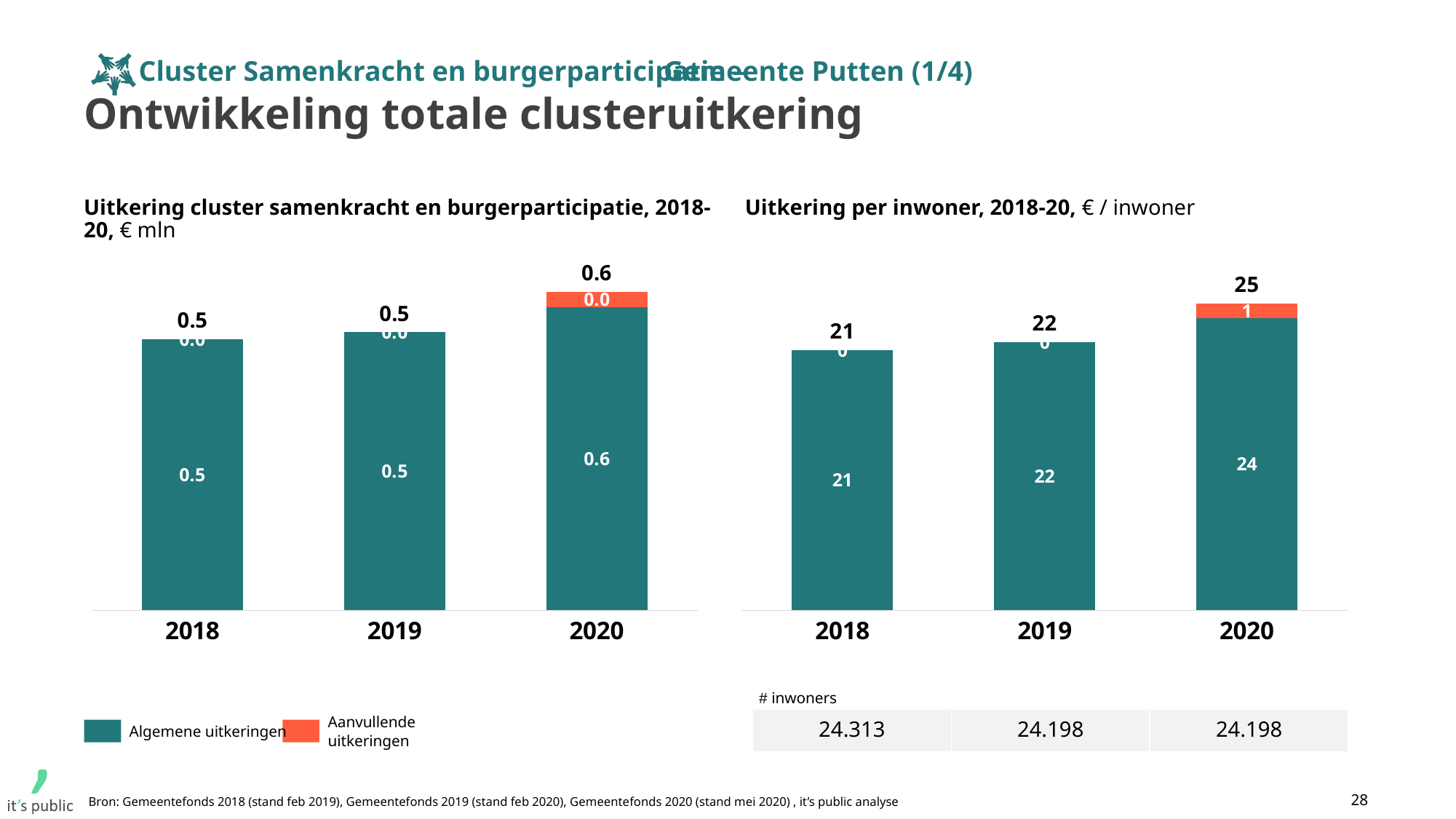
How many series does the legend list for the charts on the slide? 2 What kind of chart is the chart 'Uitkering per inwoner, 2018-20'? stacked bar chart In the chart 'Uitkering per inwoner, 2018-20', do the totals rise or fall from 2018 to 2020? rise In the chart 'Uitkering per inwoner, 2018-20', what is the value of Algemene uitkeringen for 2019? 22 In the chart 'Uitkering per inwoner, 2018-20', what is the difference between the total for 2020 and the total for 2018? 4 In the chart 'Uitkering per inwoner, 2018-20', what is the value of Aanvullende uitkeringen for 2020? 1 In the chart 'Uitkering cluster samenkracht en burgerparticipatie, 2018-20', what is the total value for 2020? 0.6 In the chart 'Uitkering per inwoner, 2018-20', which year has the lowest total? 2018 In the chart 'Uitkering cluster samenkracht en burgerparticipatie, 2018-20', how many years are shown on the x axis? 3 In the chart 'Uitkering per inwoner, 2018-20', which year has the highest total? 2020 In the chart 'Uitkering per inwoner, 2018-20', what is the total value for 2020? 25 In the chart 'Uitkering cluster samenkracht en burgerparticipatie, 2018-20', what is the value of Algemene uitkeringen for 2018? 0.5